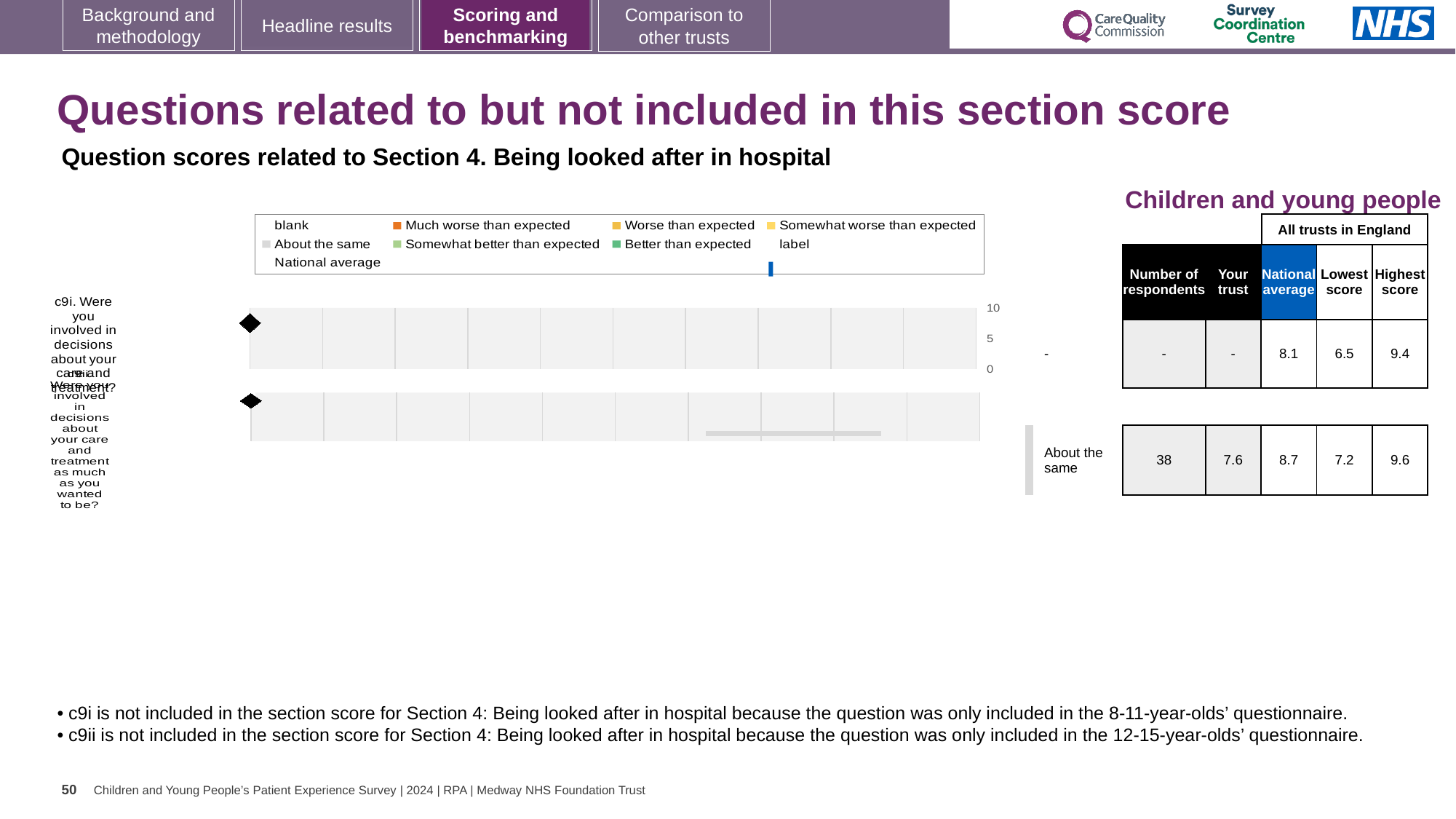
What is the highest value shown on the chart's axis? 10 What is the difference between the highest score and the lowest score for c9ii in the table? 2.4 What kind of chart is shown on the slide? bar chart In the table, what is the lowest score for c9i? 6.5 What is the difference between the national average and the 'Your trust' score for c9ii in the table? 1.1 In the table, what is the national average for c9i? 8.1 Which question has the higher national average in the table, c9i or c9ii? c9ii In the table, what is the highest score for c9ii? 9.6 In the table, what is the 'Your trust' score for c9ii? 7.6 In the table, what is the number of respondents for c9ii? 38 How many question categories are plotted on the chart? 2 Which legend entry is shown with a dark orange marker? Much worse than expected